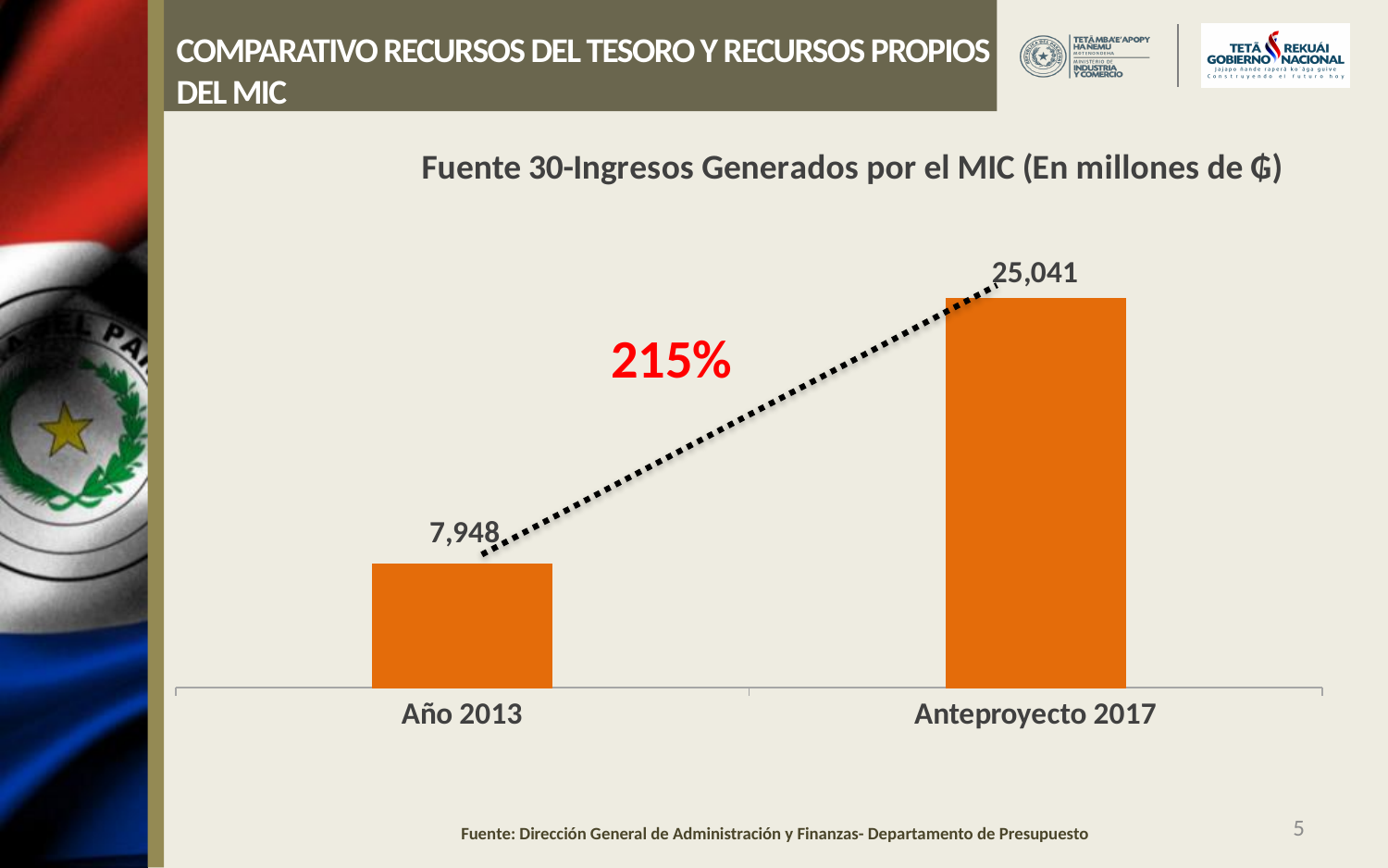
What kind of chart is shown on the slide? Bar chart What is the value for Anteproyecto 2017? 25,041 How many categories are shown on the chart? 2 Do the values rise or fall from Año 2013 to Anteproyecto 2017? Rise What is the value for Año 2013? 7,948 Which category has the lowest value? Año 2013 What is the difference between the values for Anteproyecto 2017 and Año 2013? 17,093 Which is larger, the value for Año 2013 or the value for Anteproyecto 2017? Anteproyecto 2017 Which category has the highest value? Anteproyecto 2017 What is the title of the chart? Fuente 30-Ingresos Generados por el MIC (En millones de ₲) What percentage is printed in red next to the dotted line on the chart? 215%